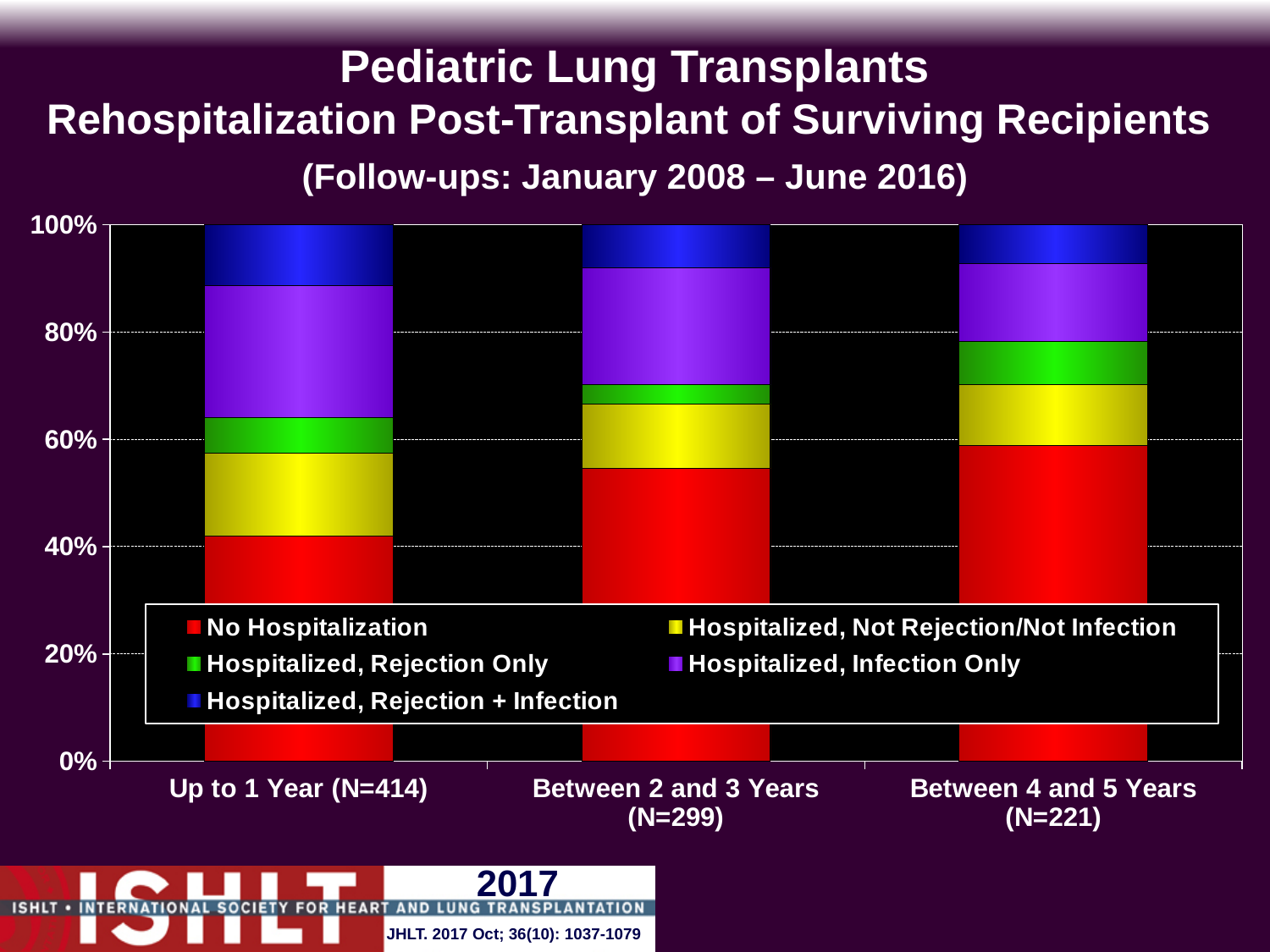
What kind of chart is shown on the slide? Stacked bar chart Which follow-up category has the largest Hospitalized, Rejection + Infection share? Up to 1 Year (N=414) How many series does the legend list? 5 How many follow-up time categories are shown on the x axis? 3 Which follow-up category has the smallest No Hospitalization share? Up to 1 Year (N=414) Which follow-up category has the smallest Hospitalized, Infection Only share? Between 4 and 5 Years (N=221) Which colour represents No Hospitalization in the legend? Red What is the sample size (N) for the Between 4 and 5 Years category? 221 Which is larger, the No Hospitalization share for Between 2 and 3 Years or for Up to 1 Year? Between 2 and 3 Years Is the No Hospitalization share for Up to 1 Year greater or less than 60%? less Is the No Hospitalization share for Between 2 and 3 Years greater or less than 40%? greater Does the No Hospitalization share rise or fall from Up to 1 Year to Between 4 and 5 Years? Rise